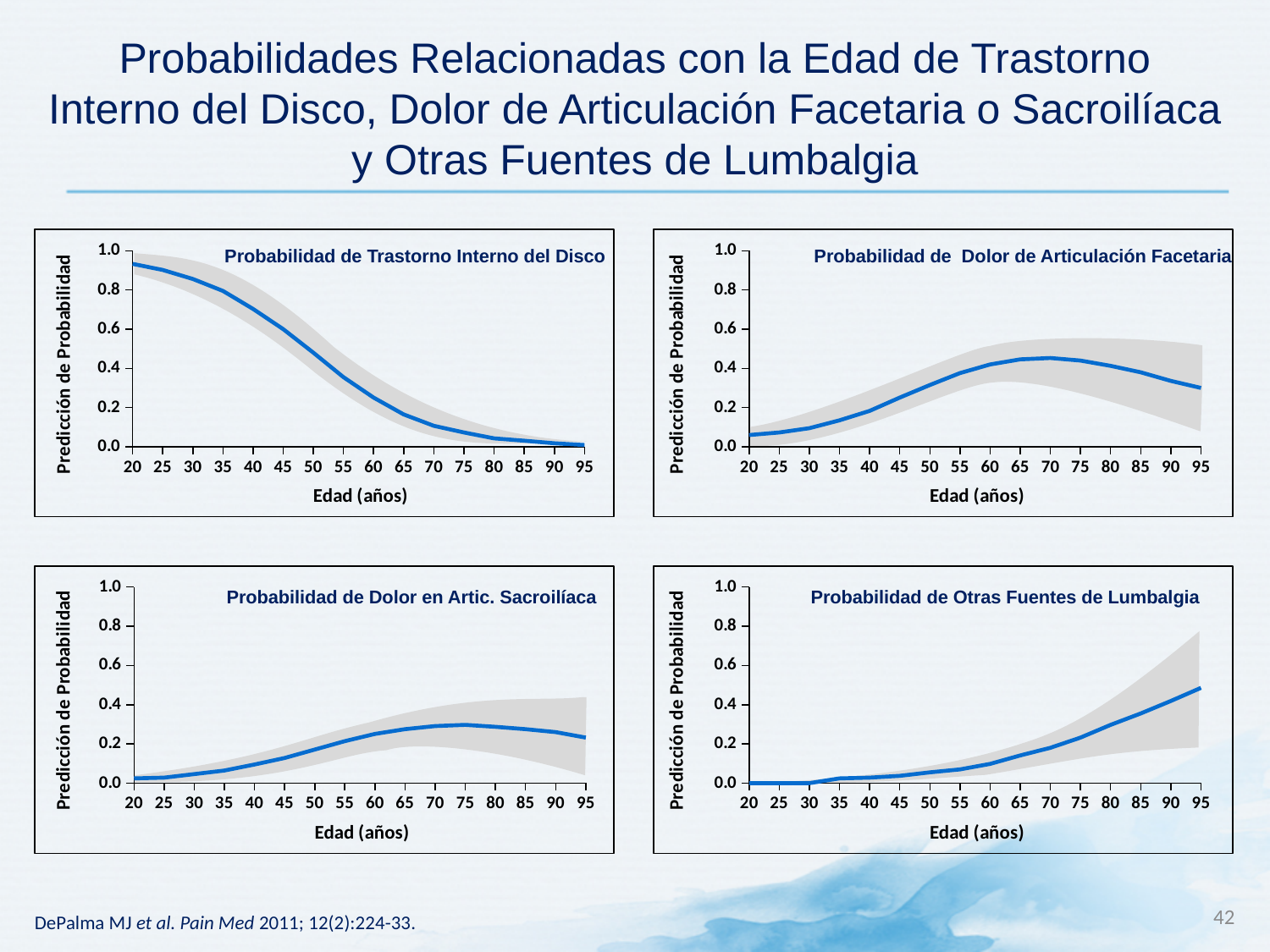
How many charts are shown on the slide? 4 What is the x-axis label of the chart 'Probabilidad de Dolor en Artic. Sacroilíaca'? Edad (años) In the chart 'Probabilidad de Dolor en Artic. Sacroilíaca', is the predicted probability at age 75 greater or less than 0.4? less In the chart 'Probabilidad de Trastorno Interno del Disco', does the predicted probability rise or fall as age increases? Fall In the chart 'Probabilidad de Otras Fuentes de Lumbalgia', does the predicted probability rise or fall as age increases? Rise In the chart 'Probabilidad de Otras Fuentes de Lumbalgia', is the predicted probability at age 95 greater or less than 0.4? greater What is the y-axis label of the chart 'Probabilidad de Otras Fuentes de Lumbalgia'? Predicción de Probabilidad At age 20, which is larger: the predicted probability in 'Probabilidad de Trastorno Interno del Disco' or in 'Probabilidad de Dolor de Articulación Facetaria'? Probabilidad de Trastorno Interno del Disco In the chart 'Probabilidad de Dolor de Articulación Facetaria', is the predicted probability at age 20 greater or less than 0.2? less What kind of chart is 'Probabilidad de Trastorno Interno del Disco'? Line chart